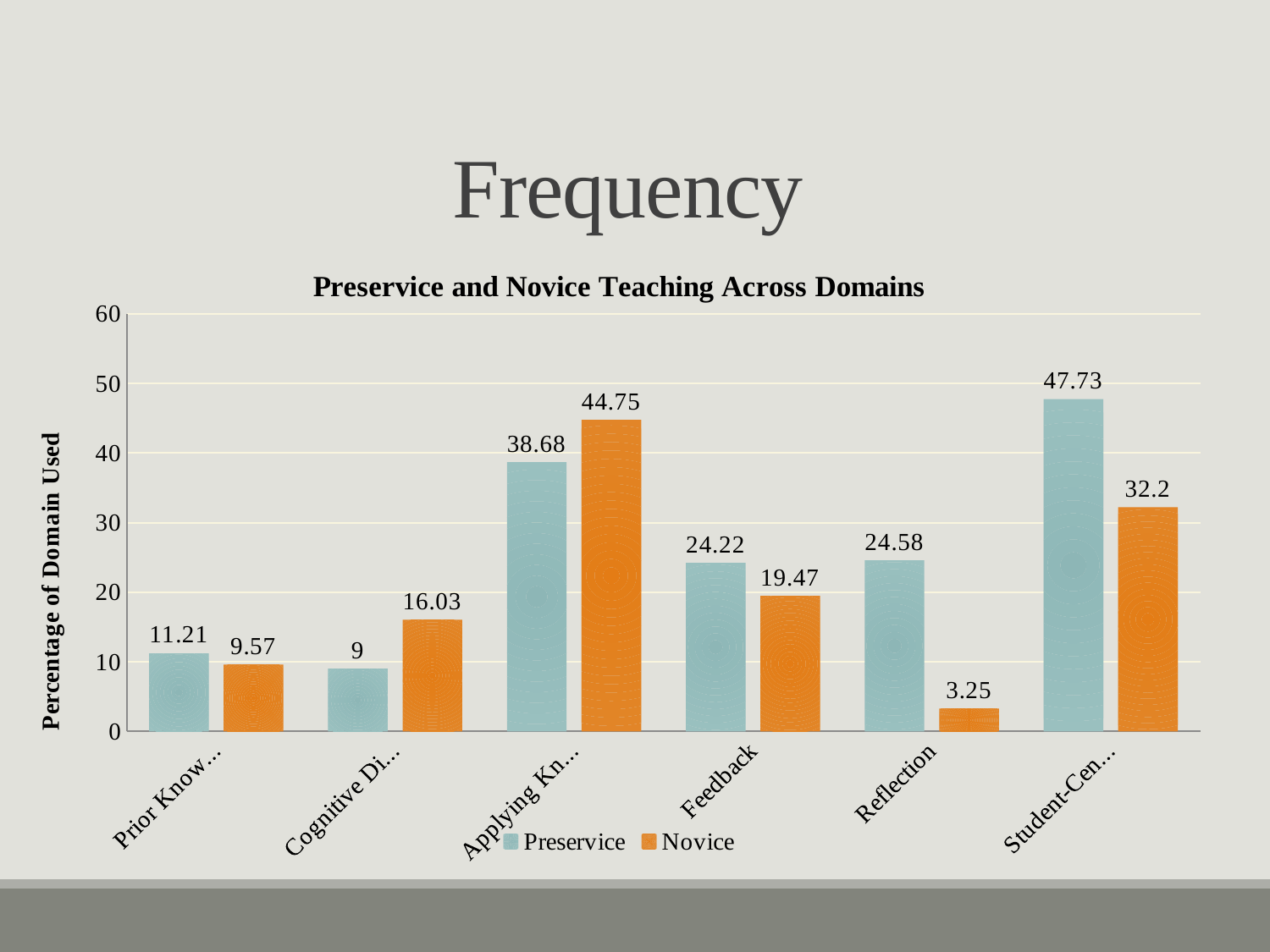
What is the title of the y axis? Percentage of Domain Used What is the Preservice value for Feedback? 24.22 For Reflection, what is the difference between the Preservice and Novice values? 21.33 For Feedback, how much higher is the Preservice value than the Novice value? 4.75 For Feedback, which series has the larger value, Preservice or Novice? Preservice What is the Preservice value for Reflection? 24.58 How many series does the legend list? 2 What is the lowest Novice value shown in the chart? 3.25 What is the Novice value for Feedback? 19.47 How many domain categories are shown on the x axis? 6 What is the Novice value for Reflection? 3.25 What is the highest Preservice value shown in the chart? 47.73